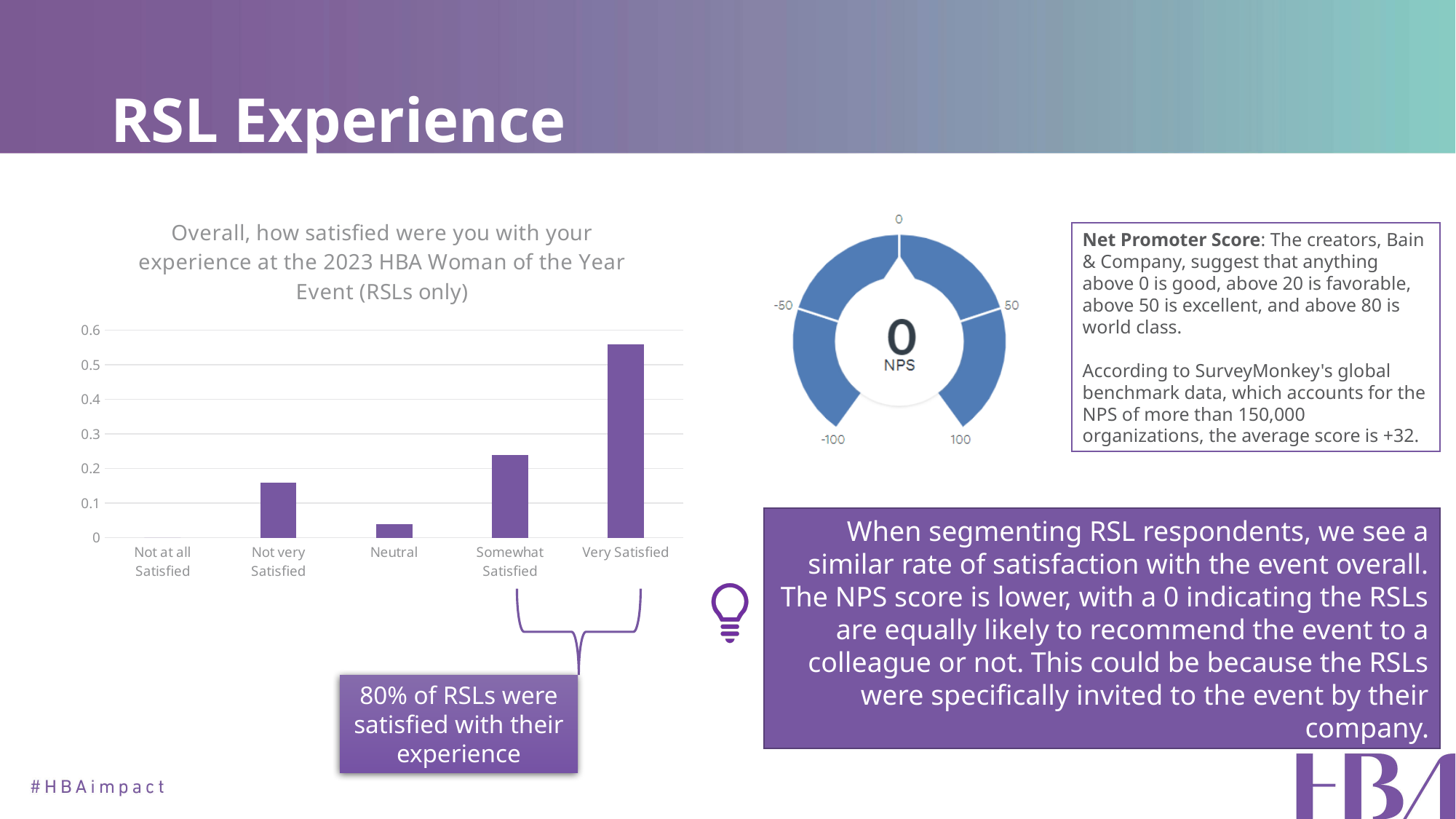
In the bar chart, which is larger: the value for Somewhat Satisfied or the value for Not very Satisfied? Somewhat Satisfied What kind of chart is used to show the satisfaction responses on the left of the slide? bar chart In the bar chart, is the value for Neutral greater or less than 0.1? less In the bar chart, is the value for Very Satisfied greater or less than 0.5? greater In the bar chart, which is larger: the value for Not very Satisfied or the value for Neutral? Not very Satisfied What NPS value is displayed in the centre of the gauge chart? 0 What is the highest value marked on the NPS gauge scale? 100 In the bar chart, which satisfaction category has the highest bar? Very Satisfied How many satisfaction categories are shown on the x axis of the bar chart? 5 In the bar chart, is the value for Somewhat Satisfied greater or less than 0.3? less What is the title of the bar chart on the left of the slide? Overall, how satisfied were you with your experience at the 2023 HBA Woman of the Year Event (RSLs only)